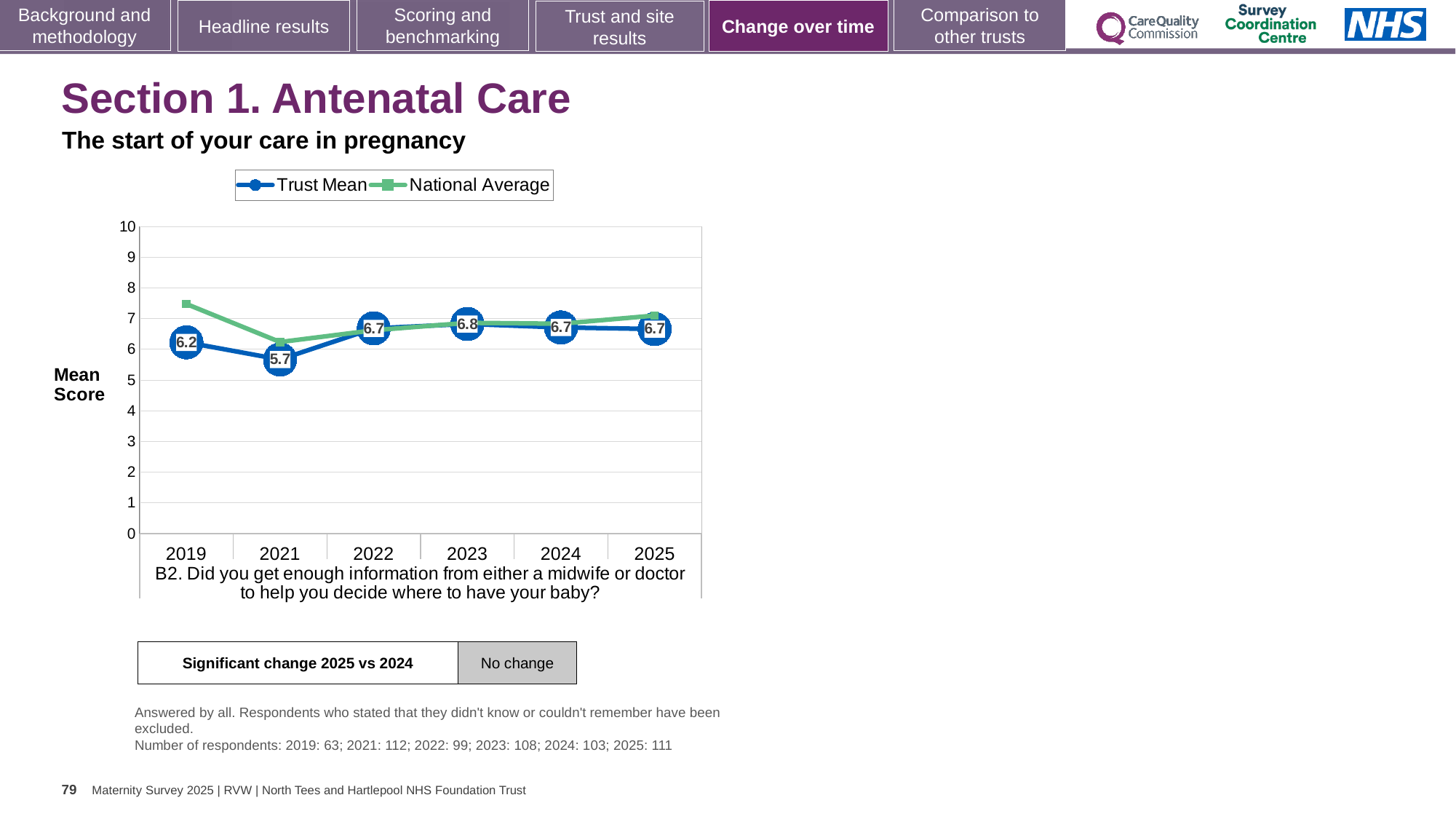
What is the difference between the Trust Mean in 2023 and in 2021? 1.1 What is the Trust Mean value for 2019? 6.2 What is the Trust Mean value for 2021? 5.7 Is the National Average value for 2019 greater or less than 7? greater What is the Trust Mean value for 2023? 6.8 How many years are shown on the x axis? 6 What is the Trust Mean value for 2025? 6.7 In which year is the Trust Mean lowest? 2021 What kind of chart is shown on the slide? Line chart Which year has the larger Trust Mean, 2019 or 2021? 2019 In which year is the Trust Mean highest? 2023 How many series does the legend list? 2